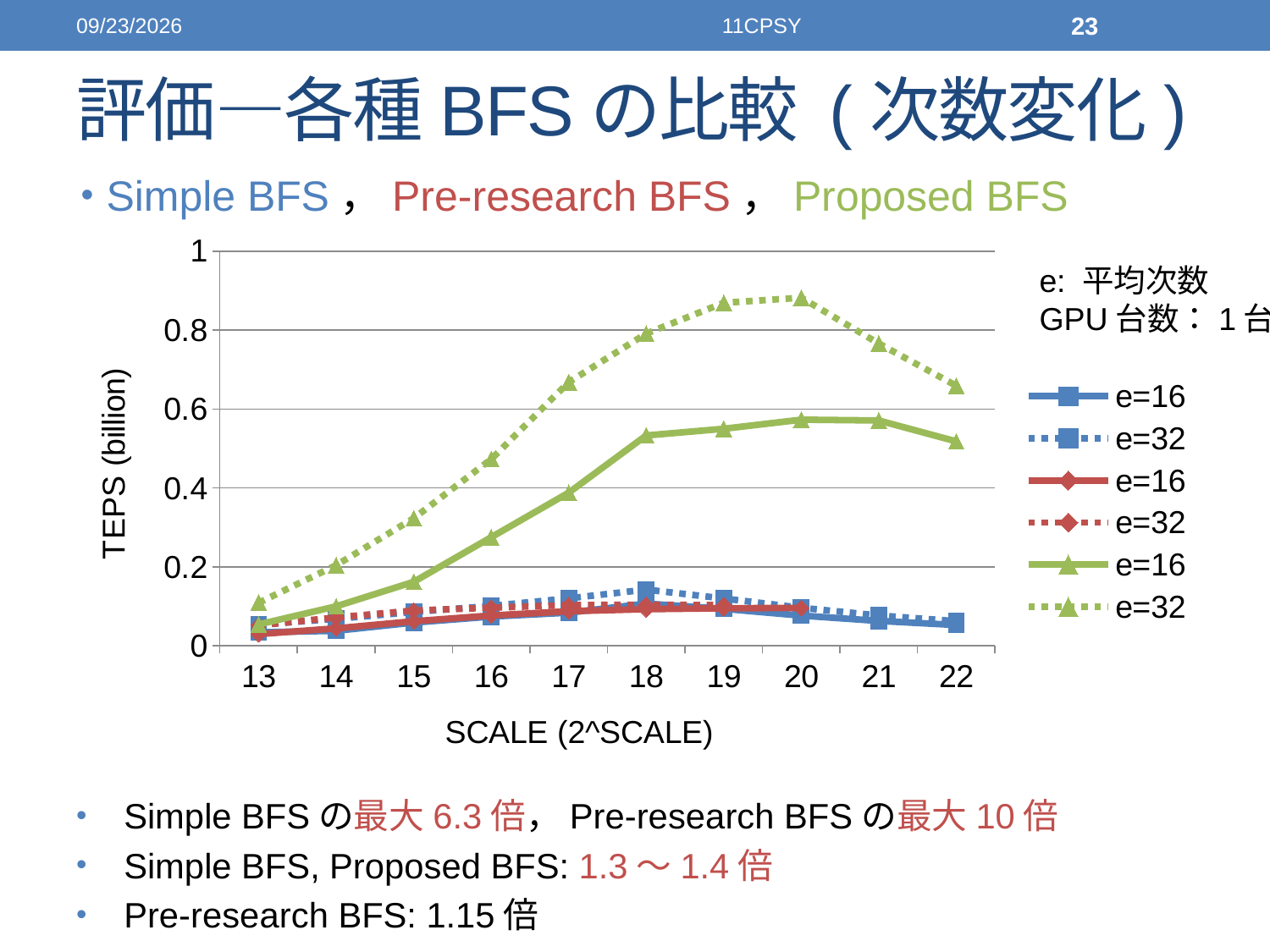
How many series does the chart legend list? 6 What is the label of the chart's y axis? TEPS (billion) At SCALE 22, is the green solid e=16 line (Proposed BFS) higher or lower than the blue solid e=16 line (Simple BFS)? higher What kind of chart is shown on the slide? line chart At which SCALE value does the green dotted e=32 line (Proposed BFS) reach its highest TEPS? 20 How many SCALE values are shown along the x axis of the chart? 10 Is the value of the green dotted e=32 line (Proposed BFS) at SCALE 18 greater or less than 0.6? greater Does the green dotted e=32 line (Proposed BFS) rise or fall from SCALE 20 to SCALE 22? fall Does the green solid e=16 line (Proposed BFS) rise or fall from SCALE 13 to SCALE 18? rise Is the value of the green solid e=16 line (Proposed BFS) at SCALE 18 greater or less than 0.4? greater Is the value of the green solid e=16 line (Proposed BFS) at SCALE 16 greater or less than 0.4? less